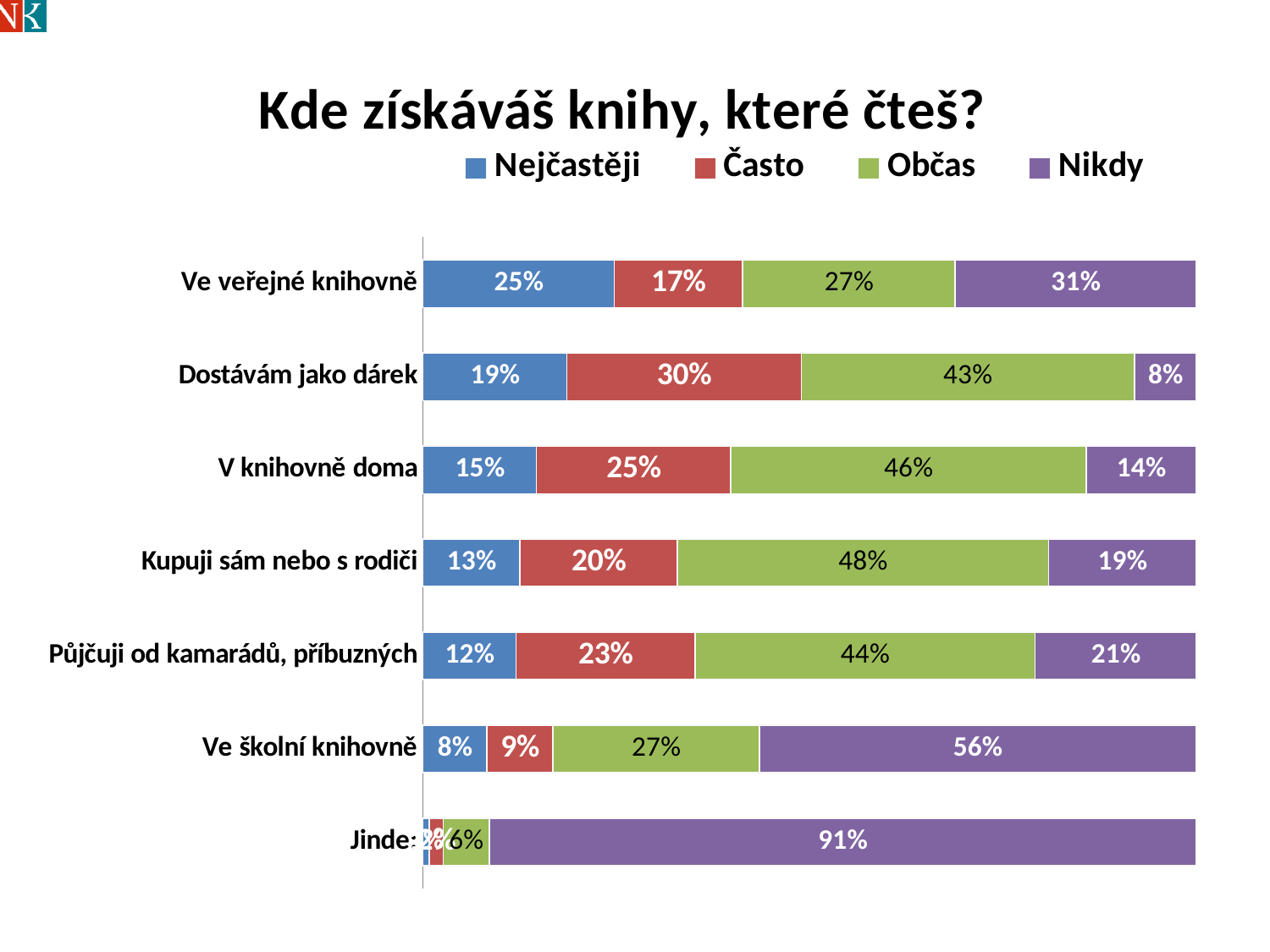
How many series does the legend list? 4 How many categories are shown on the chart? 7 Which is larger: the 'Občas' value for 'V knihovně doma' or for 'Dostávám jako dárek'? V knihovně doma Which category has the highest 'Nikdy' value? Jinde What is the 'Nikdy' value for 'Ve školní knihovně'? 56% Which category has the highest 'Nejčastěji' value? Ve veřejné knihovně What type of chart is shown on the slide? stacked bar chart What is the 'Často' value for 'Dostávám jako dárek'? 30% What is the difference between the 'Nikdy' values for 'Ve školní knihovně' and 'Ve veřejné knihovně'? 25% What is the 'Občas' value for 'Kupuji sám nebo s rodiči'? 48% What is the 'Nejčastěji' value for 'Půjčuji od kamarádů, příbuzných'? 12% Which category has the lowest 'Nikdy' value? Dostávám jako dárek